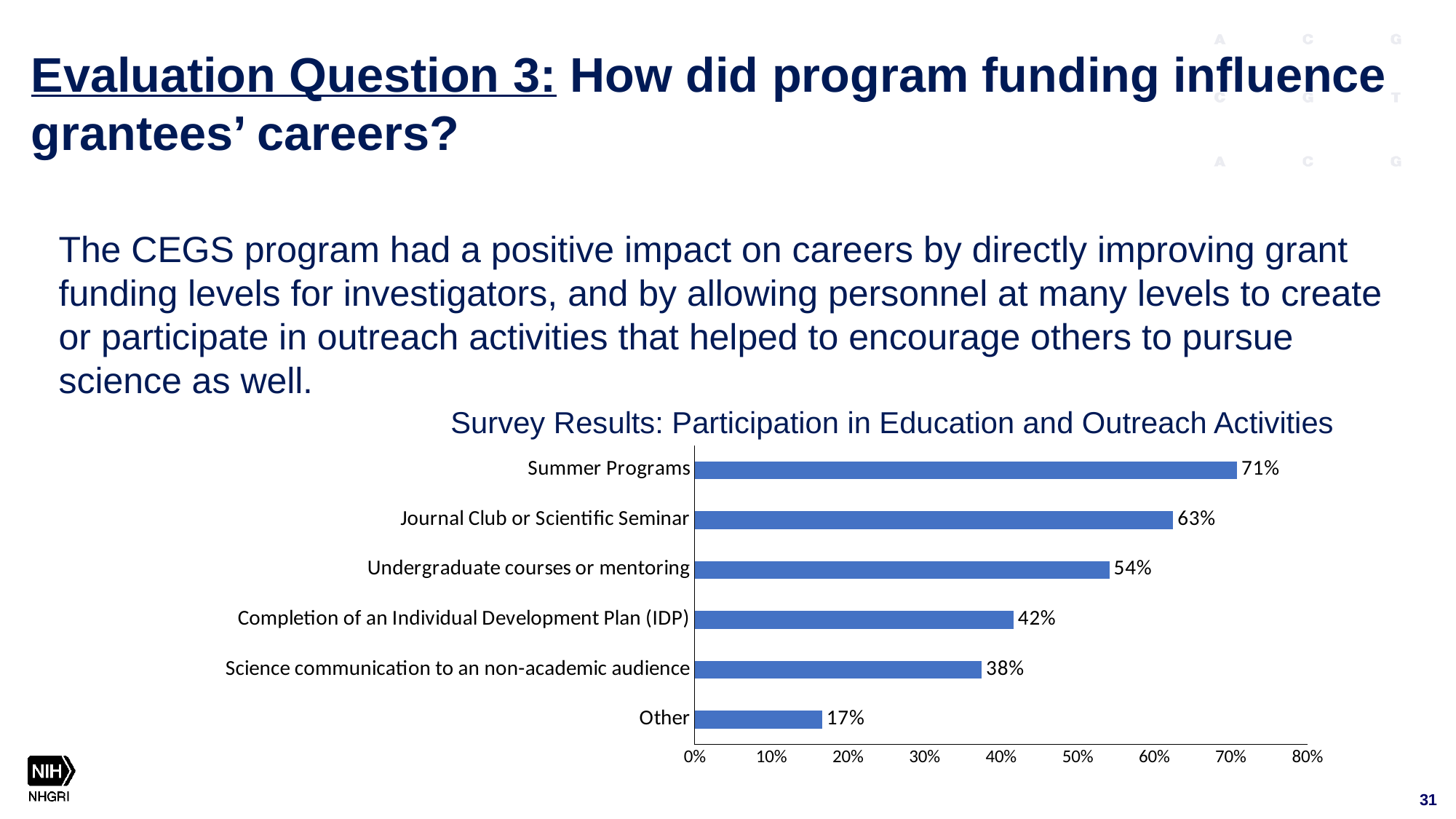
What kind of chart is shown on the slide? Bar chart Which is larger: Undergraduate courses or mentoring or Completion of an Individual Development Plan (IDP)? Undergraduate courses or mentoring What percentage of respondents participated in Summer Programs? 71% What is the value for Journal Club or Scientific Seminar? 63% How many activities are shown in the chart? 6 Which activity has the highest participation? Summer Programs What is the difference between Summer Programs and Undergraduate courses or mentoring? 17% What is the difference between Science communication to an non-academic audience and Other? 21% Which activity has the lowest participation? Other What is the title of the chart? Survey Results: Participation in Education and Outreach Activities What is the value for Other? 17% What is the value for Completion of an Individual Development Plan (IDP)? 42%